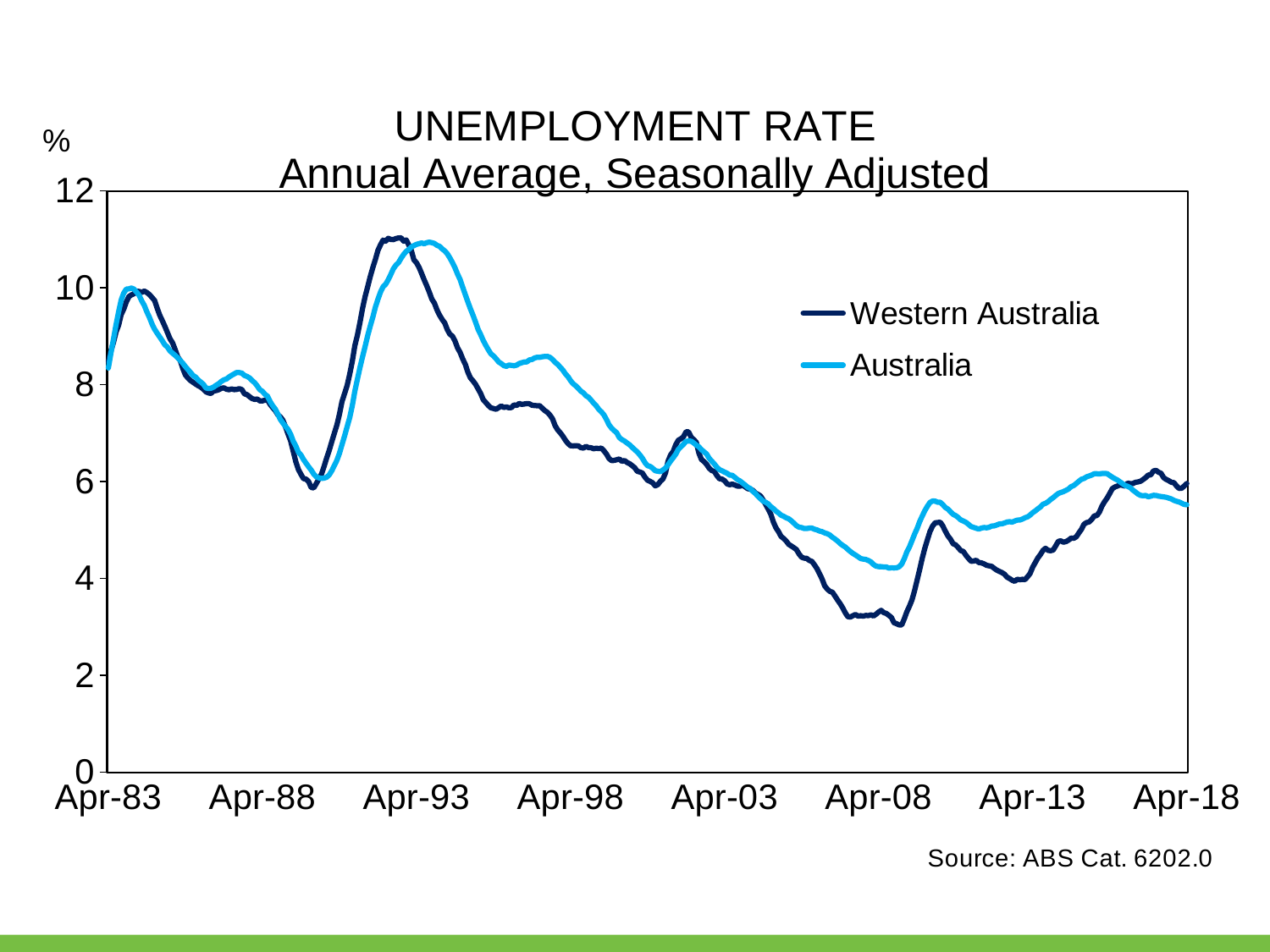
Is the value for Australia at Apr-18 greater or less than 6? less How many series does the legend list? 2 At Apr-08, which series has the higher unemployment rate, Western Australia or Australia? Australia Is the value for Western Australia at Apr-98 greater or less than 6? greater Is the value for Western Australia at Apr-93 greater or less than 10? greater What is the title of the chart? UNEMPLOYMENT RATE Annual Average, Seasonally Adjusted Does the Western Australia line rise or fall between Apr-88 and Apr-93? rise What kind of chart is shown on the slide? line chart What source is cited below the chart? ABS Cat. 6202.0 At Apr-13, which series has the higher unemployment rate, Western Australia or Australia? Australia